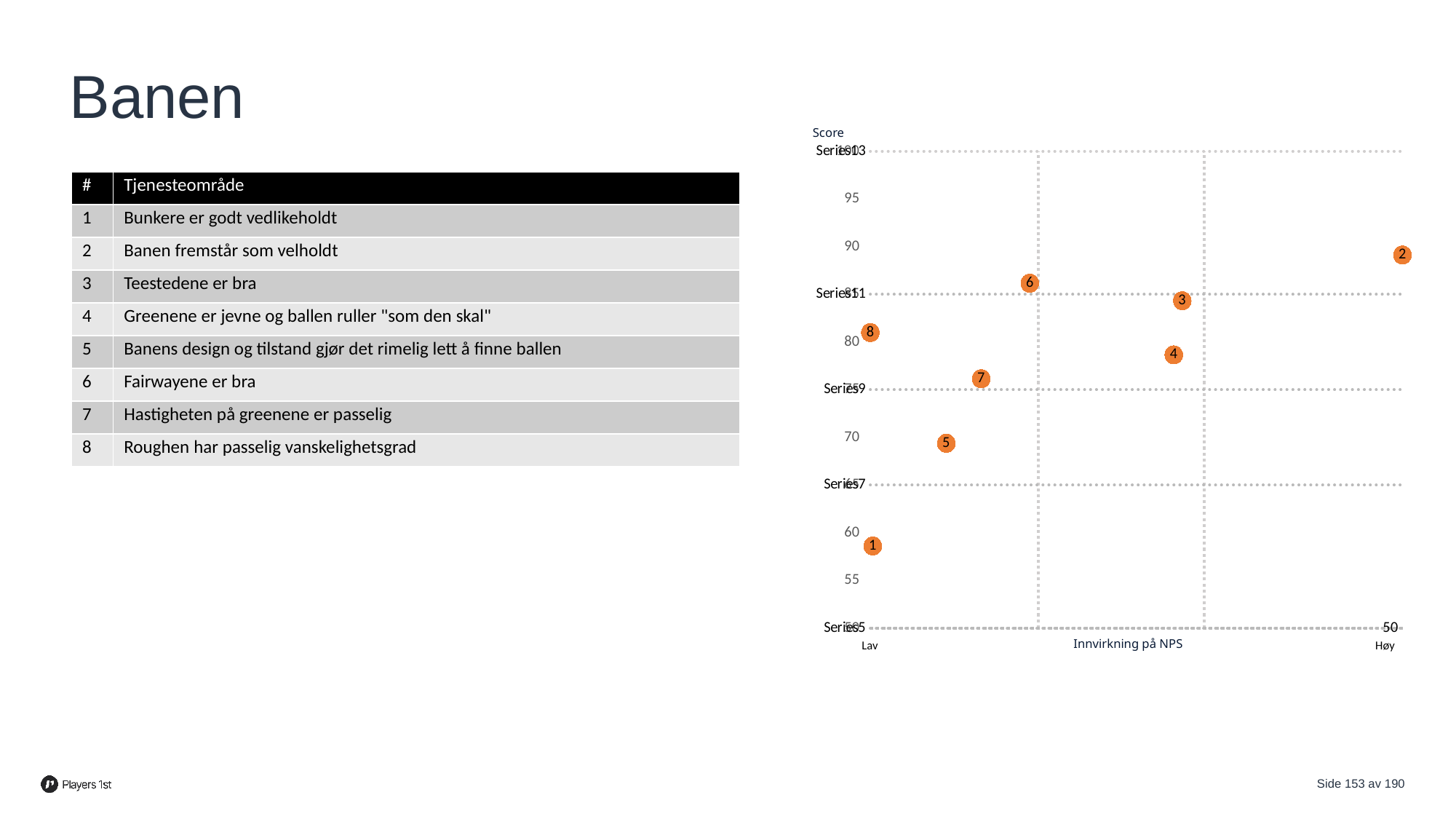
How many numbered points are plotted on the chart? 8 Which numbered point has the highest score on the chart? 2 Is the score for point 4 greater or less than 80? less Is the score for point 1 greater or less than 60? less Is the score for point 3 greater or less than 80? greater Which numbered point has the lowest score on the chart? 1 Which has the higher score, point 6 or point 5? 6 Which point is furthest to the right on the 'Innvirkning på NPS' axis? 2 What is the title of the vertical axis of the chart? Score What kind of chart is shown on the slide? scatter chart